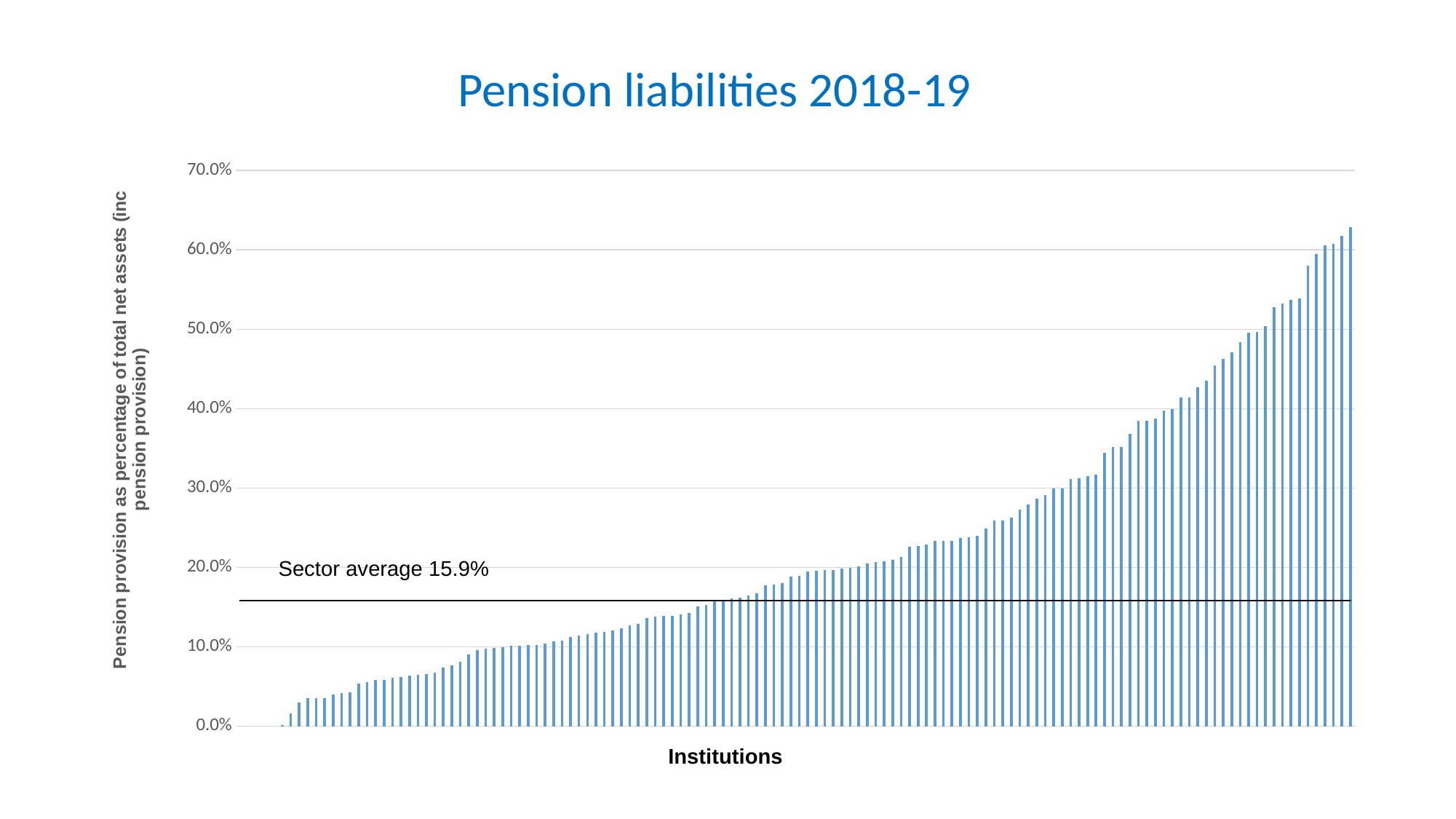
Is the value of the shortest bar greater or less than 10%? less Do the bar values rise or fall from left to right along the x axis? rise What is the title of the chart? Pension liabilities 2018-19 Is the value of the tallest bar greater or less than 60%? greater What sector average value is annotated on the chart? 15.9% What kind of chart is shown on the slide? bar chart Is the value of the tallest bar greater or less than 70%? less What is the label of the x axis? Institutions